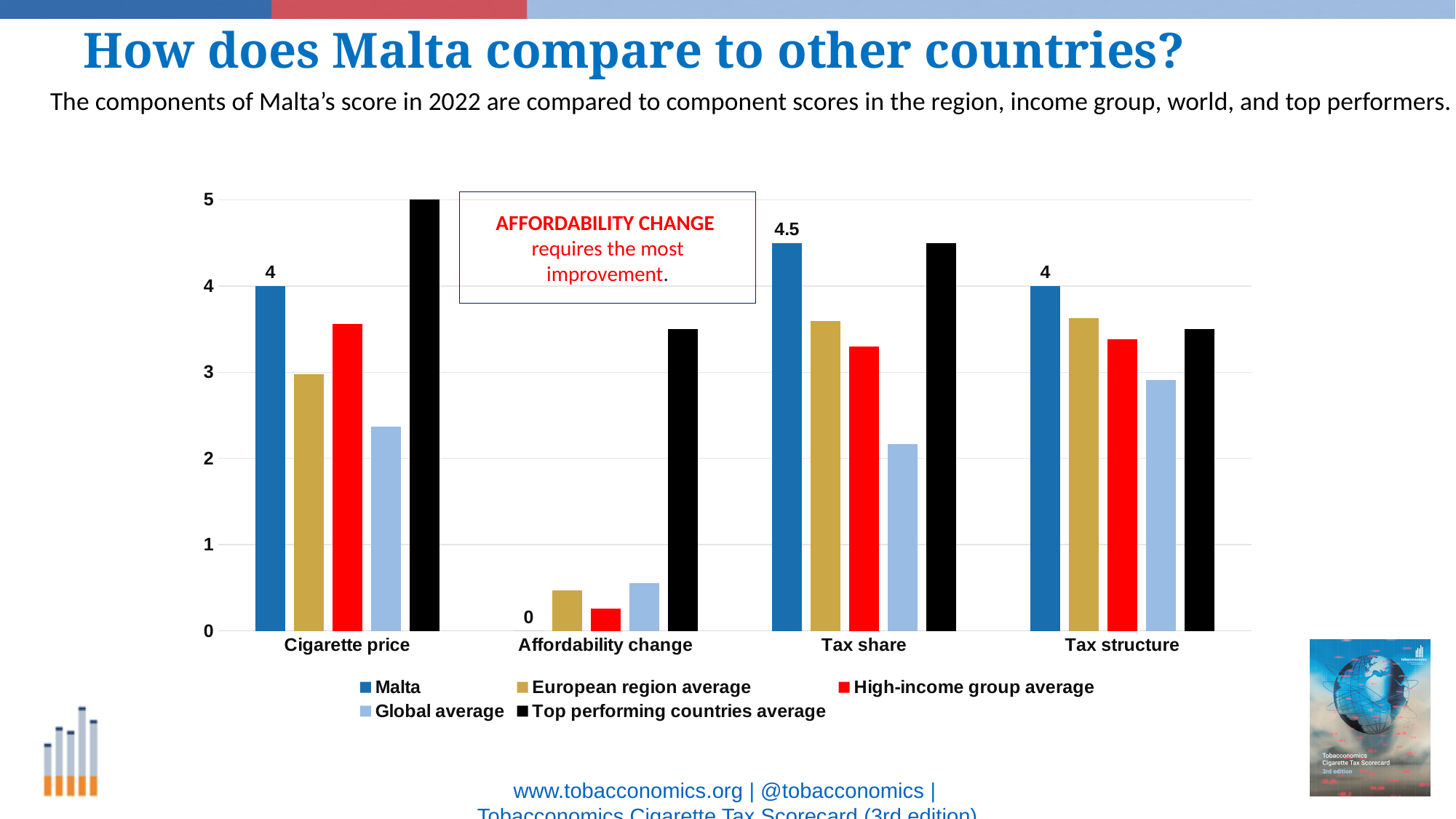
What is Malta's score for Cigarette price? 4 What is the Top performing countries average for Cigarette price? 5 What is Malta's score for Affordability change? 0 Which is larger for Malta: the Cigarette price score or the Affordability change score? Cigarette price What kind of chart is shown on the slide? bar chart Is the Global average for Cigarette price greater or less than 3? less How many components are shown on the x axis? 4 What is the difference between Malta's Tax share score and its Cigarette price score? 0.5 In which component does Malta have its lowest score? Affordability change How many series does the legend list? 5 In which component does Malta have its highest score? Tax share What is Malta's score for Tax share? 4.5